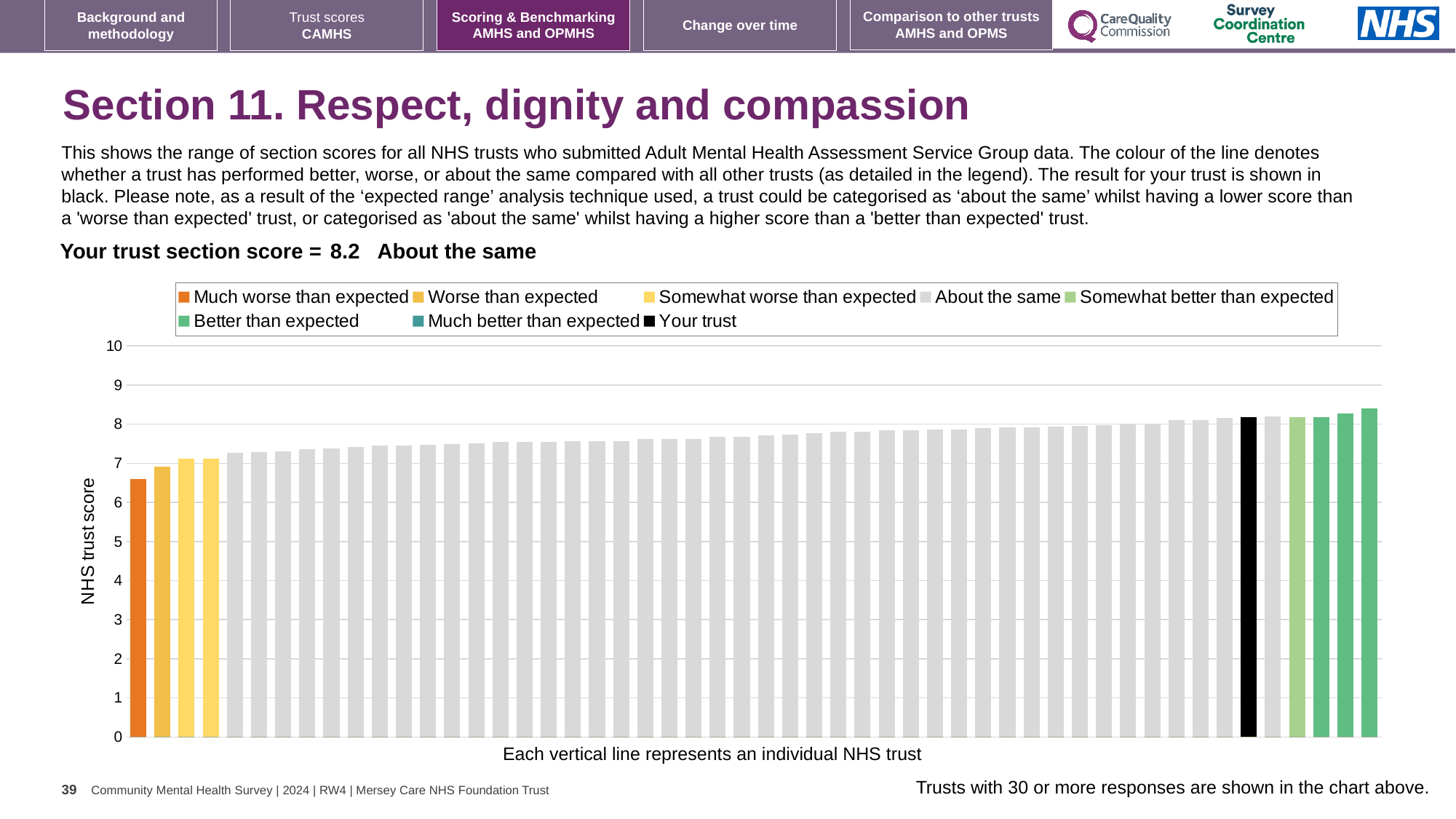
Is the value of the 'Much worse than expected' bar greater or less than 7? less Is the value of the 'Much worse than expected' bar greater or less than 6? greater What is the label on the vertical axis of the chart? NHS trust score Which legend category does the lowest bar in the chart belong to? Much worse than expected Do the bar values rise or fall from left to right along the x axis? rise Is the value of the 'Your trust' bar greater or less than 8? greater How many bars are coloured as 'Better than expected'? 3 How many entries does the chart legend list? 8 What kind of chart is shown on the slide? bar chart What is the section score for your trust shown on the slide? 8.2 What colour is used for the 'Your trust' bar in the chart? black Which legend category does the highest bar in the chart belong to? Better than expected